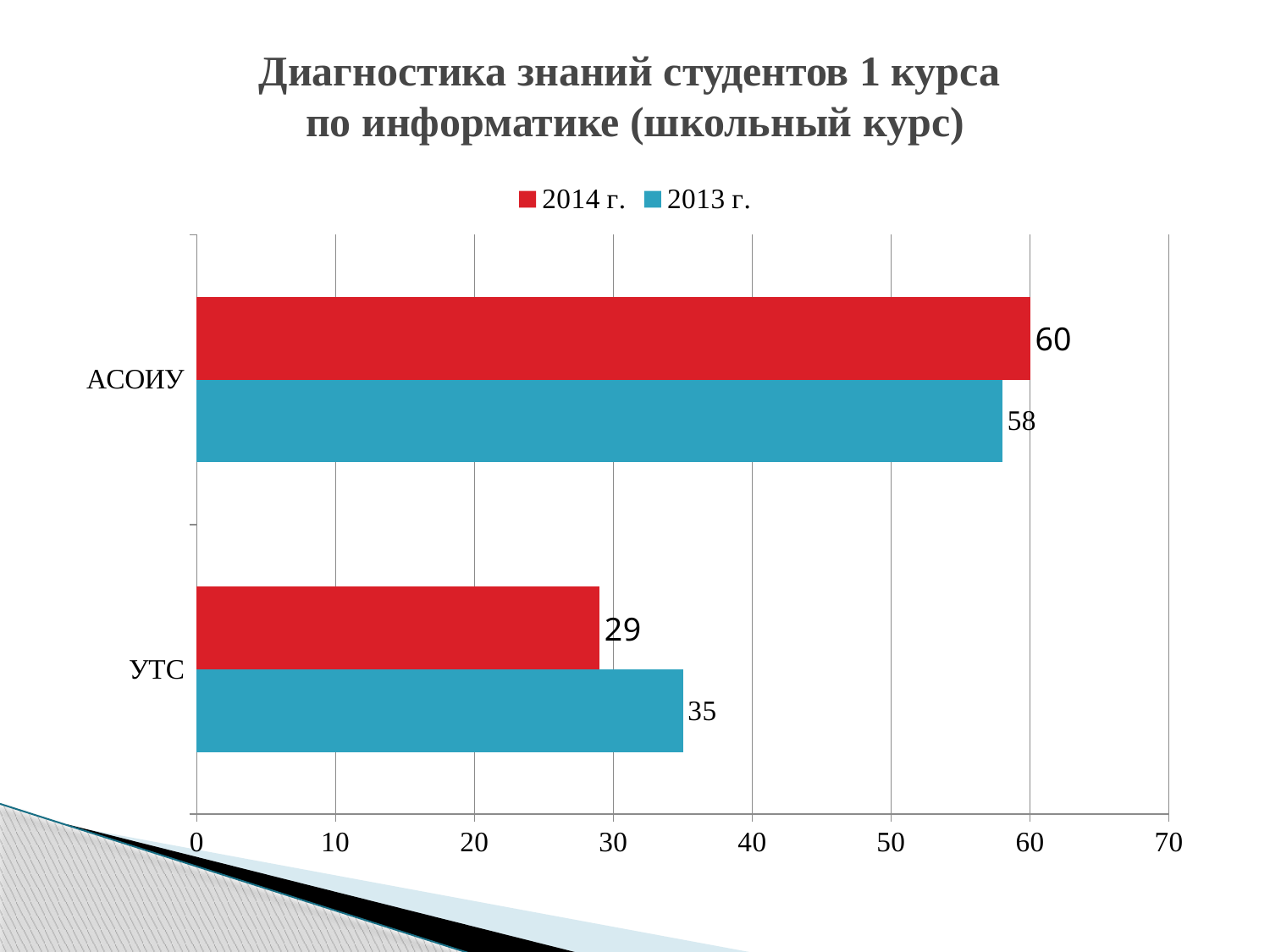
What is the value for АСОИУ in 2014 г.? 60 What kind of chart is shown on the slide? bar chart Which is larger for УТС: the 2014 г. value or the 2013 г. value? 2013 г. What is the value for АСОИУ in 2013 г.? 58 What is the difference between the 2013 г. and 2014 г. values for УТС? 6 Which category has the lowest value in the 2013 г. series? УТС How many series does the legend list? 2 What is the value for УТС in 2014 г.? 29 How many categories are shown on the chart? 2 What is the difference between the 2014 г. values for АСОИУ and УТС? 31 Which category has the highest value in the 2014 г. series? АСОИУ What is the value for УТС in 2013 г.? 35